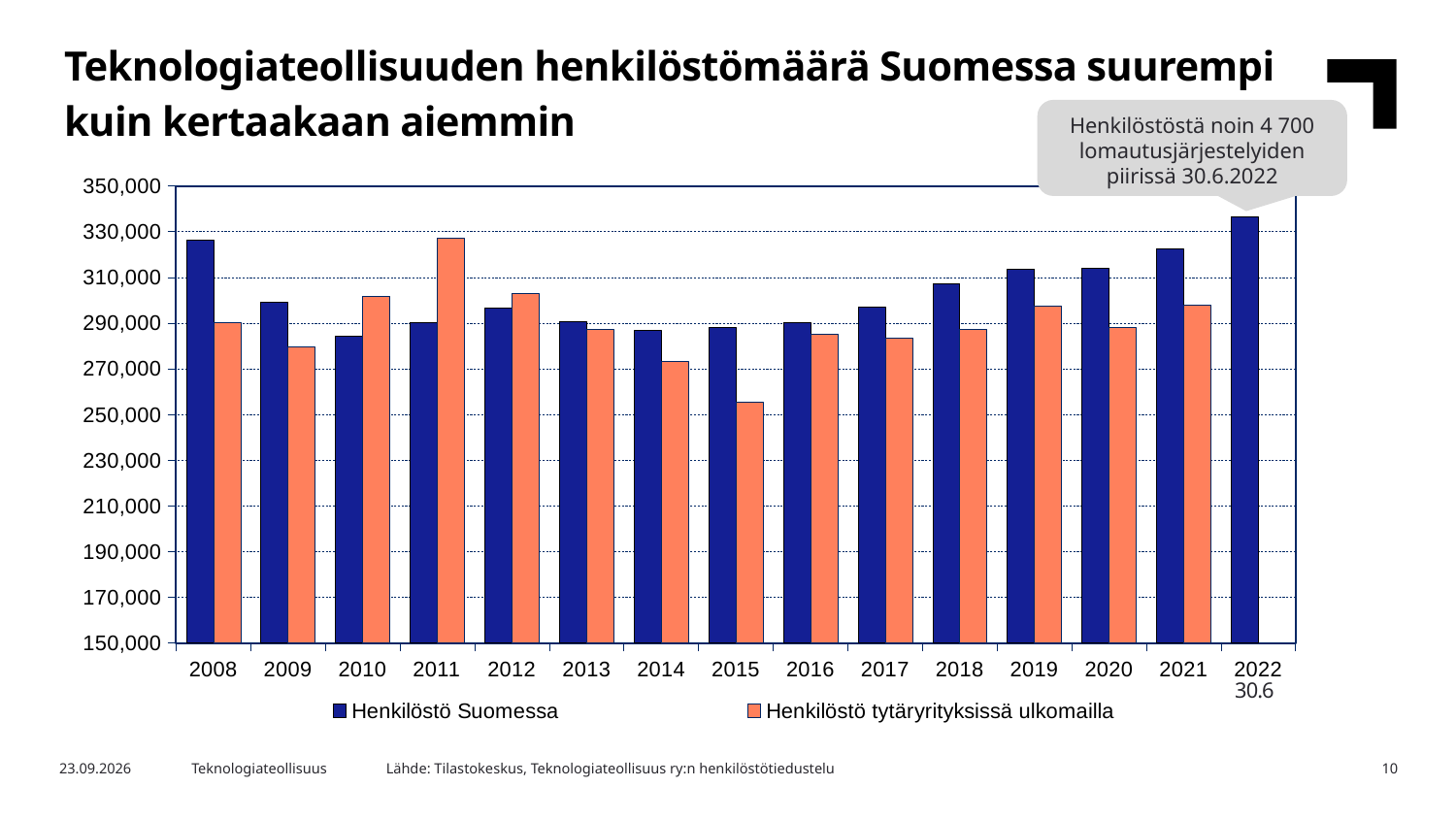
Is the value for Henkilöstö tytäryrityksissä ulkomailla in 2015 greater or less than 270,000? less How many years are shown on the x axis? 15 What are the two legend entries of the chart? Henkilöstö Suomessa; Henkilöstö tytäryrityksissä ulkomailla Is the value for Henkilöstö Suomessa in 2022 greater or less than 330,000? greater What kind of chart is shown on the slide? bar chart How many series does the legend list? 2 In 2011, which series has the larger value: Henkilöstö Suomessa or Henkilöstö tytäryrityksissä ulkomailla? Henkilöstö tytäryrityksissä ulkomailla In which year is the value for Henkilöstö tytäryrityksissä ulkomailla highest? 2011 In which year is the value for Henkilöstö Suomessa highest? 2022 Does the value for Henkilöstö Suomessa rise or fall from 2015 to 2022? rise Is the value for Henkilöstö tytäryrityksissä ulkomailla in 2014 greater or less than 290,000? less In which year is the value for Henkilöstö tytäryrityksissä ulkomailla lowest? 2015